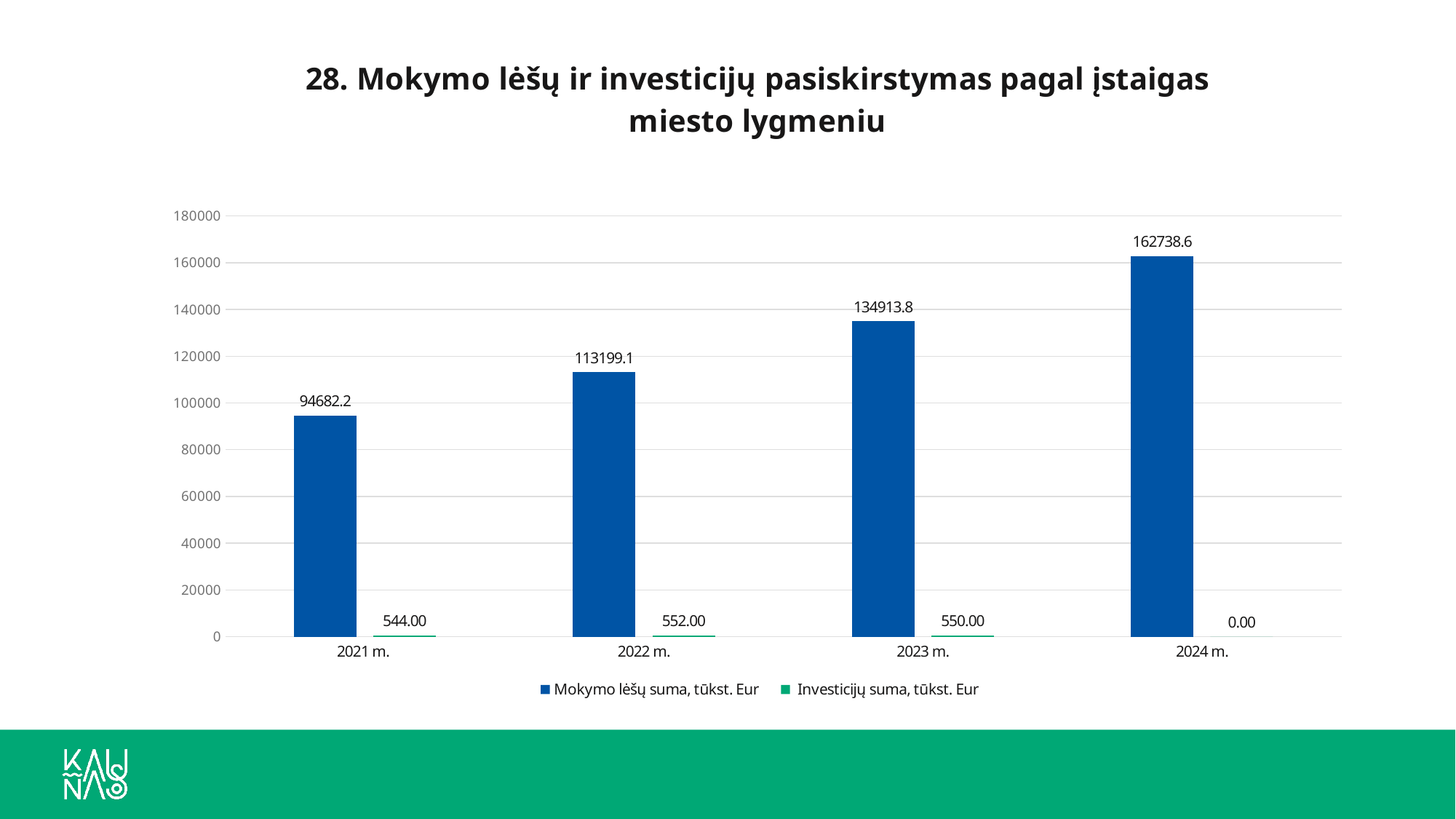
Which year has the highest Mokymo lėšų suma, tūkst. Eur? 2024 m. How many series does the legend list? 2 What is the difference between Investicijų suma, tūkst. Eur in 2022 m. and 2021 m.? 8.00 Which year has the lowest Investicijų suma, tūkst. Eur? 2024 m. What is the value of Mokymo lėšų suma, tūkst. Eur for 2021 m.? 94682.2 Which is larger: Mokymo lėšų suma, tūkst. Eur in 2022 m. or in 2023 m.? 2023 m. What is the value of Investicijų suma, tūkst. Eur for 2024 m.? 0.00 What is the value of Mokymo lėšų suma, tūkst. Eur for 2024 m.? 162738.6 How many years are shown on the x axis? 4 What is the value of Investicijų suma, tūkst. Eur for 2022 m.? 552.00 Does Mokymo lėšų suma, tūkst. Eur rise or fall from 2021 m. to 2024 m.? rise What is the difference between Mokymo lėšų suma, tūkst. Eur in 2024 m. and 2021 m.? 68056.4